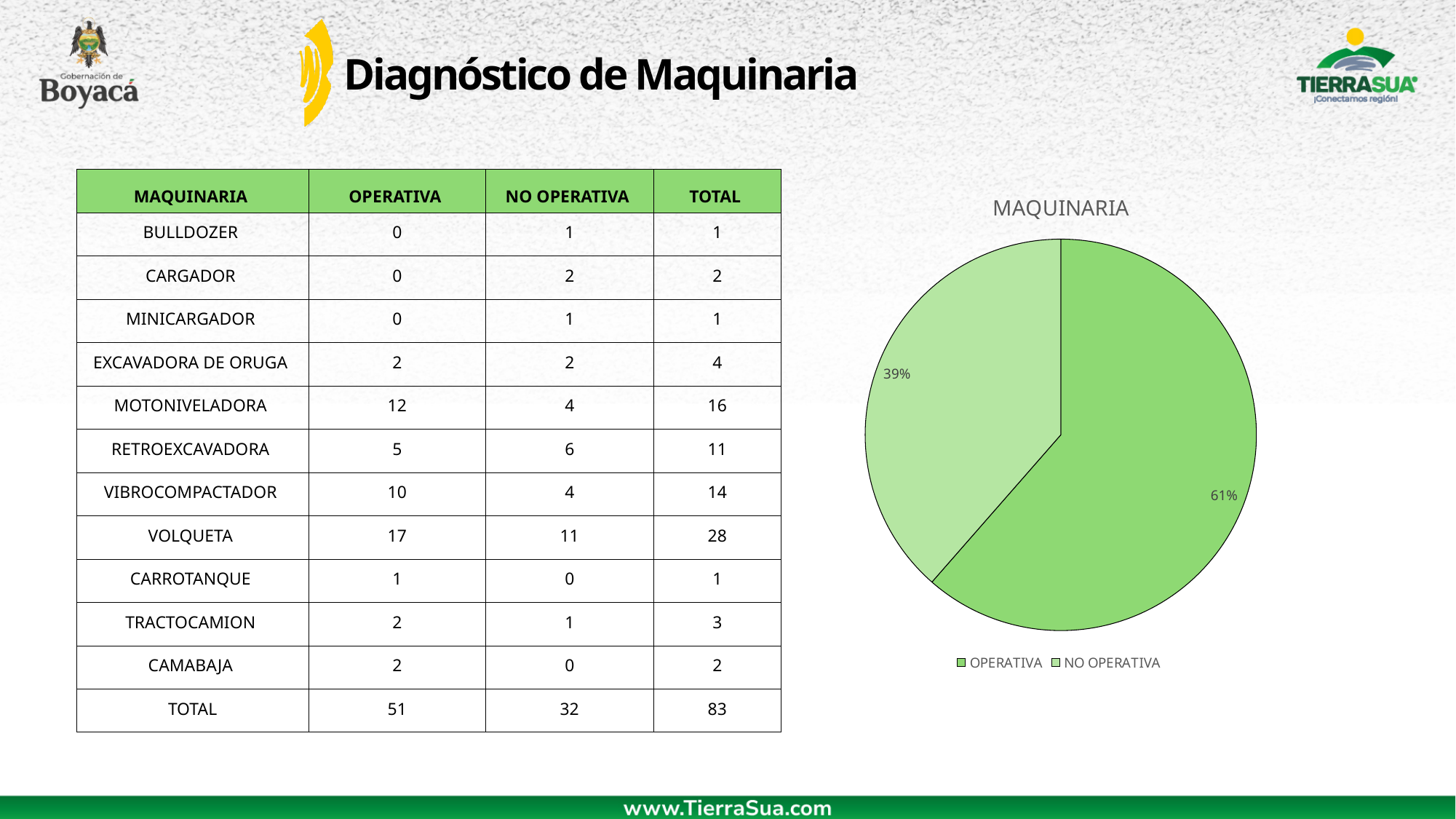
What kind of chart is shown on the slide? pie chart What is the difference in percentage points between the OPERATIVA and NO OPERATIVA slices? 22 How many entries does the legend of the pie chart list? 2 Which is larger in the pie chart, OPERATIVA or NO OPERATIVA? OPERATIVA What share of the pie chart is OPERATIVA? 61% Which slice of the pie chart is the largest? OPERATIVA Which slice of the pie chart is the smallest? NO OPERATIVA What is the title of the pie chart? MAQUINARIA Is the share for OPERATIVA greater or less than 50%? greater What are the two legend entries of the pie chart? OPERATIVA and NO OPERATIVA How many slices does the pie chart have? 2 What share of the pie chart is NO OPERATIVA? 39%